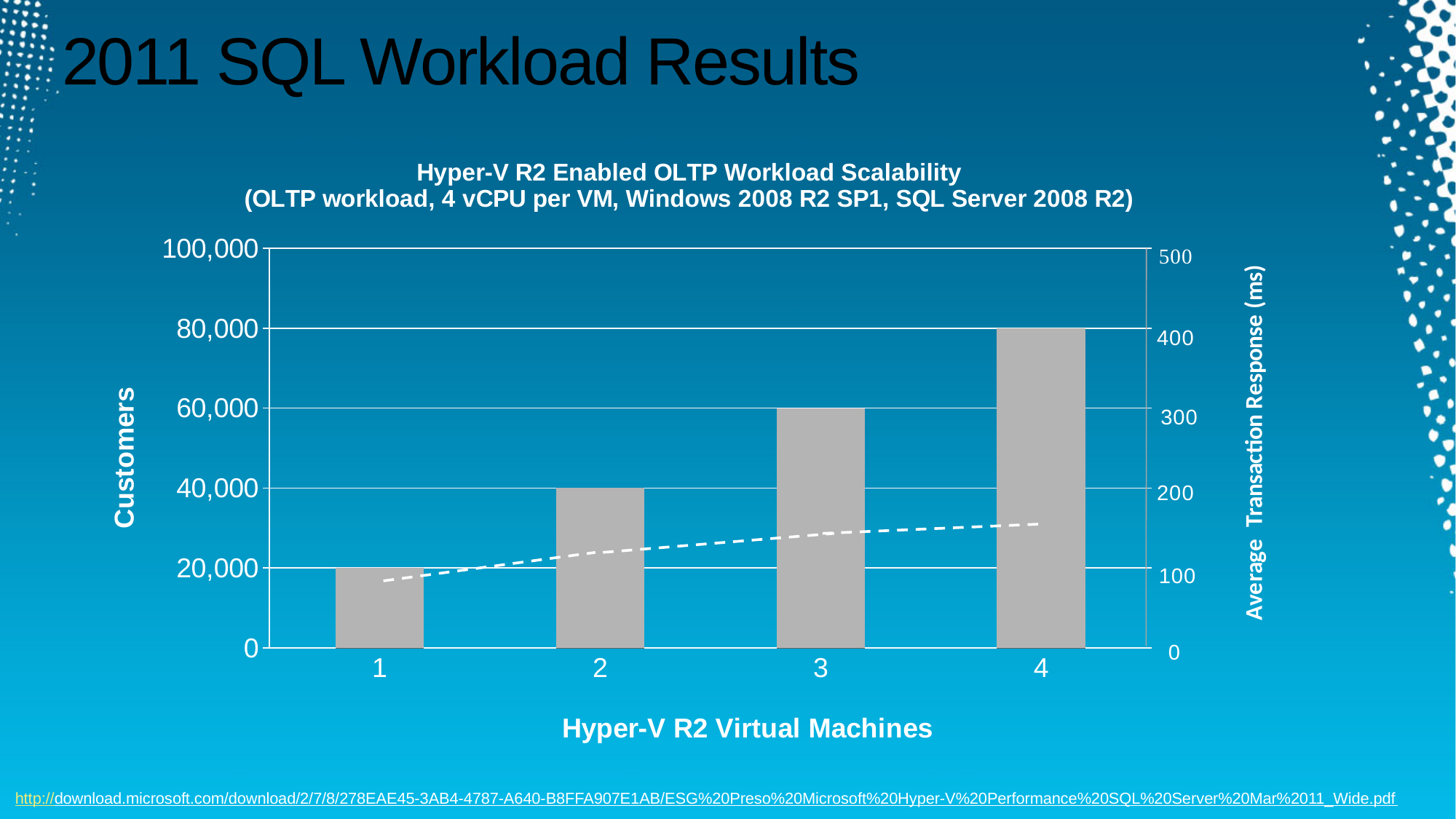
What is the Customers value for 2 Hyper-V R2 Virtual Machines? 40,000 Is the Average Transaction Response (ms) for 4 virtual machines greater or less than 200? less Which number of virtual machines has the lowest Customers value? 1 What is the label of the left vertical axis? Customers What is the Customers value for 1 Hyper-V R2 Virtual Machine? 20,000 Which number of virtual machines has the highest Customers value? 4 What is the Customers value for 4 Hyper-V R2 Virtual Machines? 80,000 What is the difference in Customers between 4 virtual machines and 1 virtual machine? 60,000 Which has more Customers, 3 virtual machines or 2 virtual machines? 3 virtual machines Do the Customers values rise or fall as the number of virtual machines increases? rise What kind of chart is shown on the slide? bar chart with a line How many Hyper-V R2 Virtual Machines categories are shown on the x axis? 4